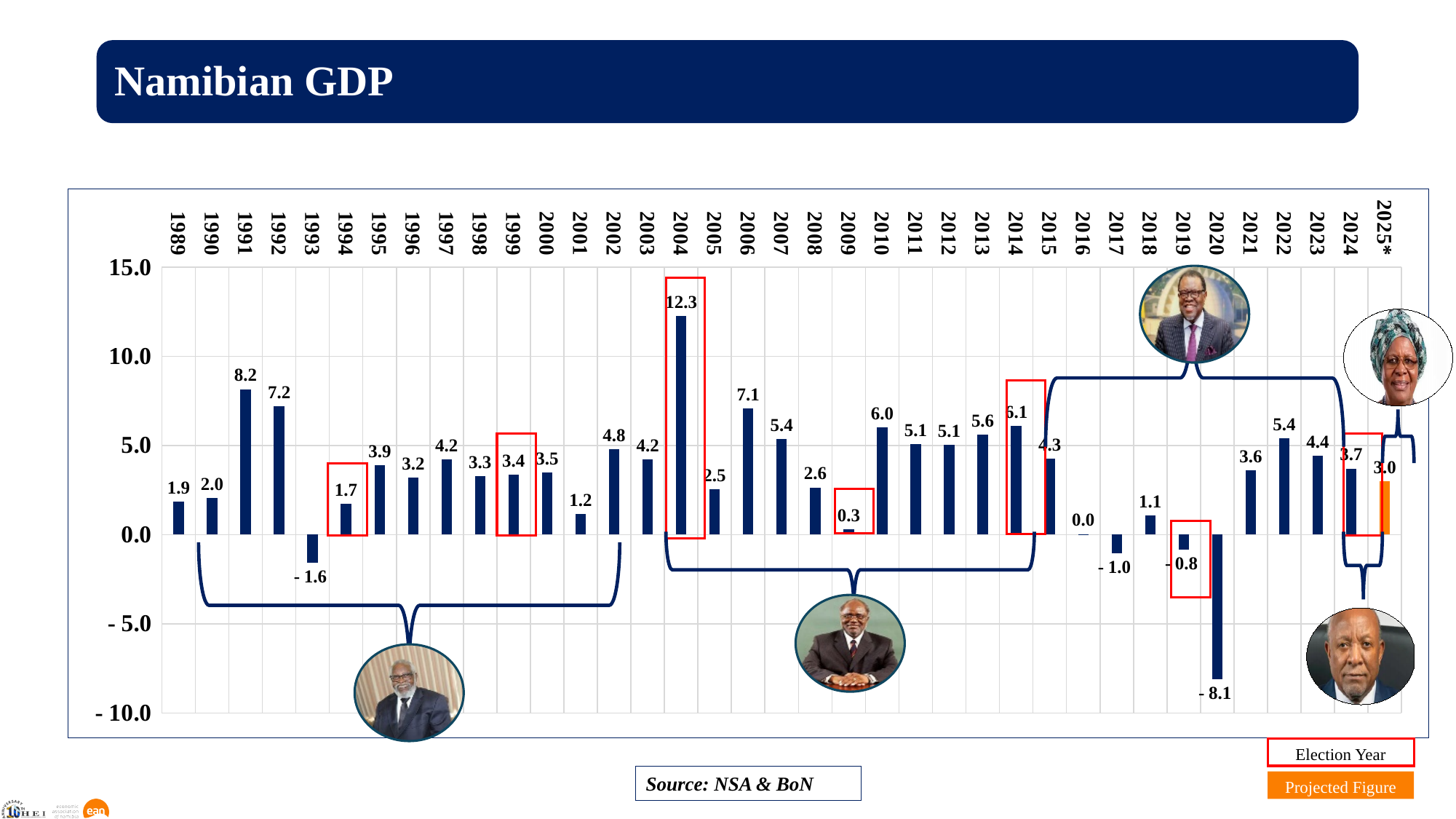
Which year has the lowest GDP value on the chart? 2020 What source is cited for the chart? NSA & BoN Which year has the highest GDP value on the chart? 2004 What is the difference between the values for 1991 and 1992? 1.0 What kind of chart is shown on the slide? Bar chart What is the value shown for 2020? - 8.1 What do the red boxes around certain bars indicate, according to the legend? Election Year What is the projected figure shown for 2025*? 3.0 What is the Namibian GDP value shown for 2004? 12.3 Which year has the larger value, 2006 or 2010? 2006 Do the values rise or fall from 2021 to 2024? Rise then fall How many years are plotted on the chart? 37